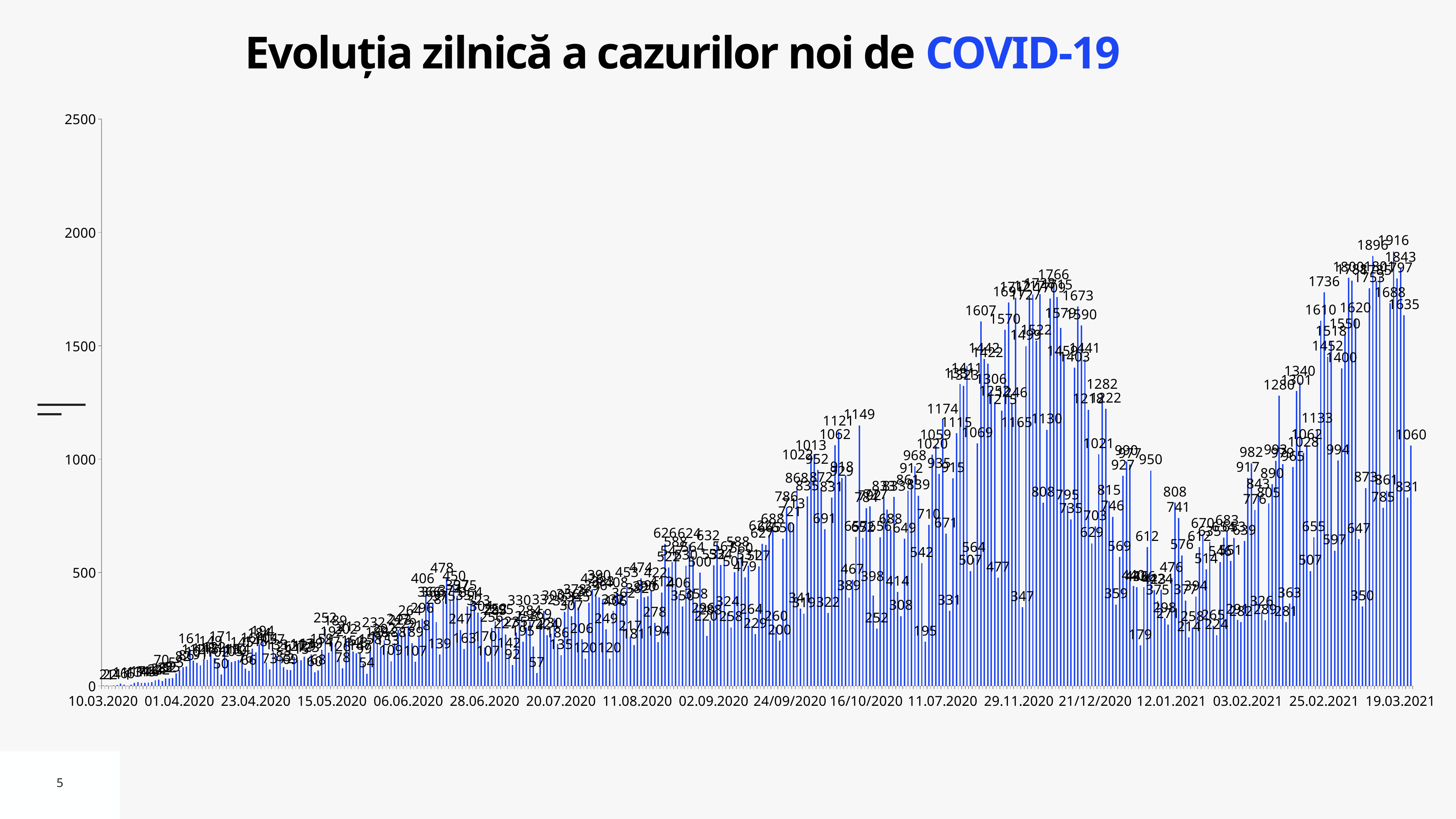
What is the title of the chart? Evoluția zilnică a cazurilor noi de COVID-19 What is the difference between the highest data label (1916) and the last bar's value (1060)? 856 Is the value of the first bar (10.03.2020) greater or less than 500? less What is the highest data label shown on the chart? 1916 What kind of chart is shown on the slide? bar chart What is the value of the last bar on the chart, at 19.03.2021? 1060 Is the value of the last bar (19.03.2021) greater or less than 1000? greater Overall, do the values rise or fall from 10.03.2020 to 19.03.2021? rise Does any bar on the chart exceed 2000? No What is the maximum value shown on the y axis? 2500 Which is larger: the highest bar around 29.11.2020 (1766) or the highest bar around 19.03.2021 (1916)? 1916 What is the first date shown on the x axis? 10.03.2020